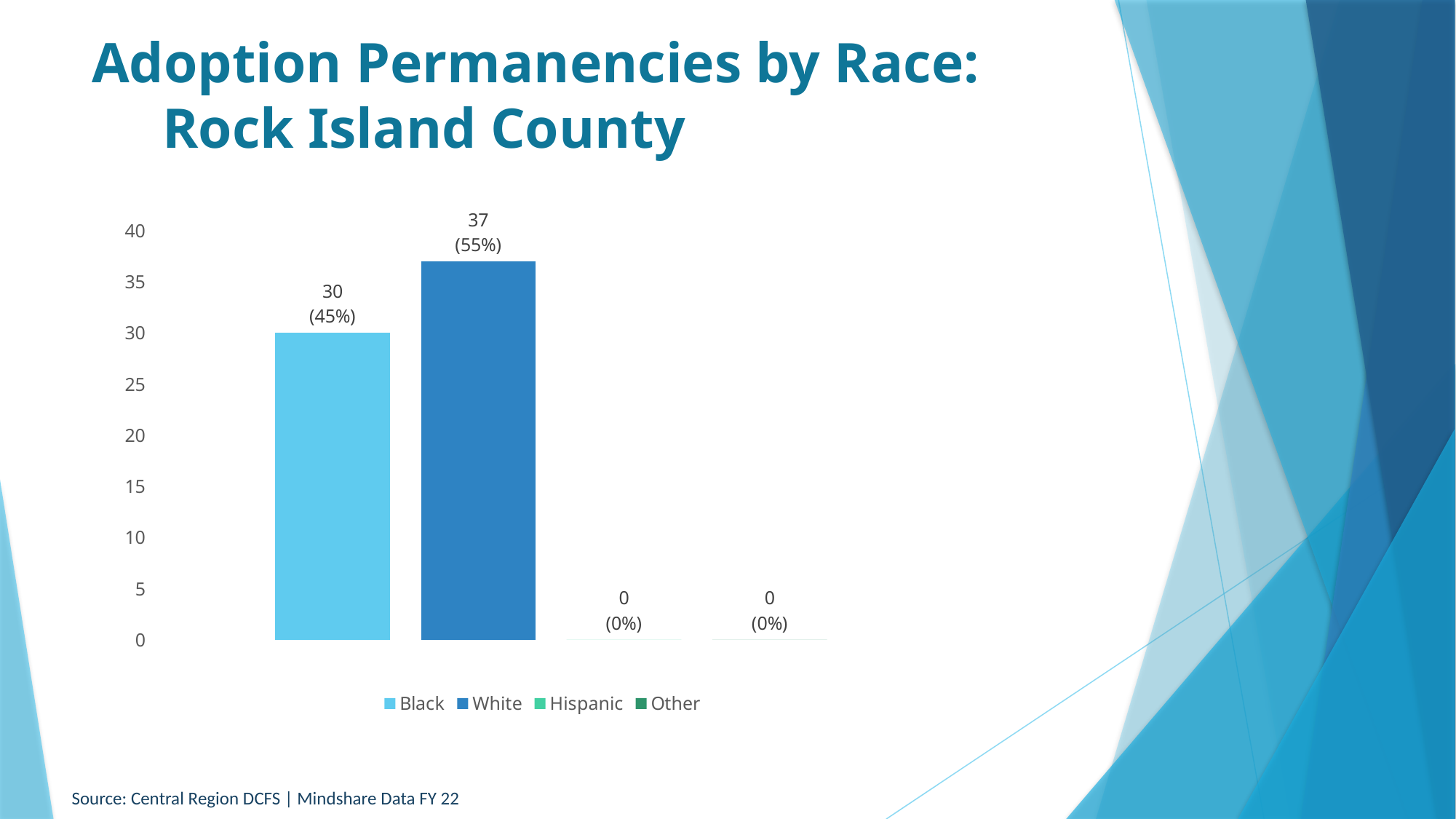
How many race categories does the legend list? 4 What is the number of adoption permanencies for Black in Rock Island County? 30 What is the value shown for Hispanic? 0 Which is larger, the value for Black or the value for White? White What is the difference between the White and Black adoption permanency counts? 7 What percentage of adoption permanencies is shown for White? 55% Which race has the highest number of adoption permanencies? White What is the total of the Black and White adoption permanency counts? 67 Is the value for White greater or less than 35? greater What percentage of adoption permanencies is shown for Black? 45% What is the number of adoption permanencies for White in Rock Island County? 37 What kind of chart is shown on the slide? Bar chart